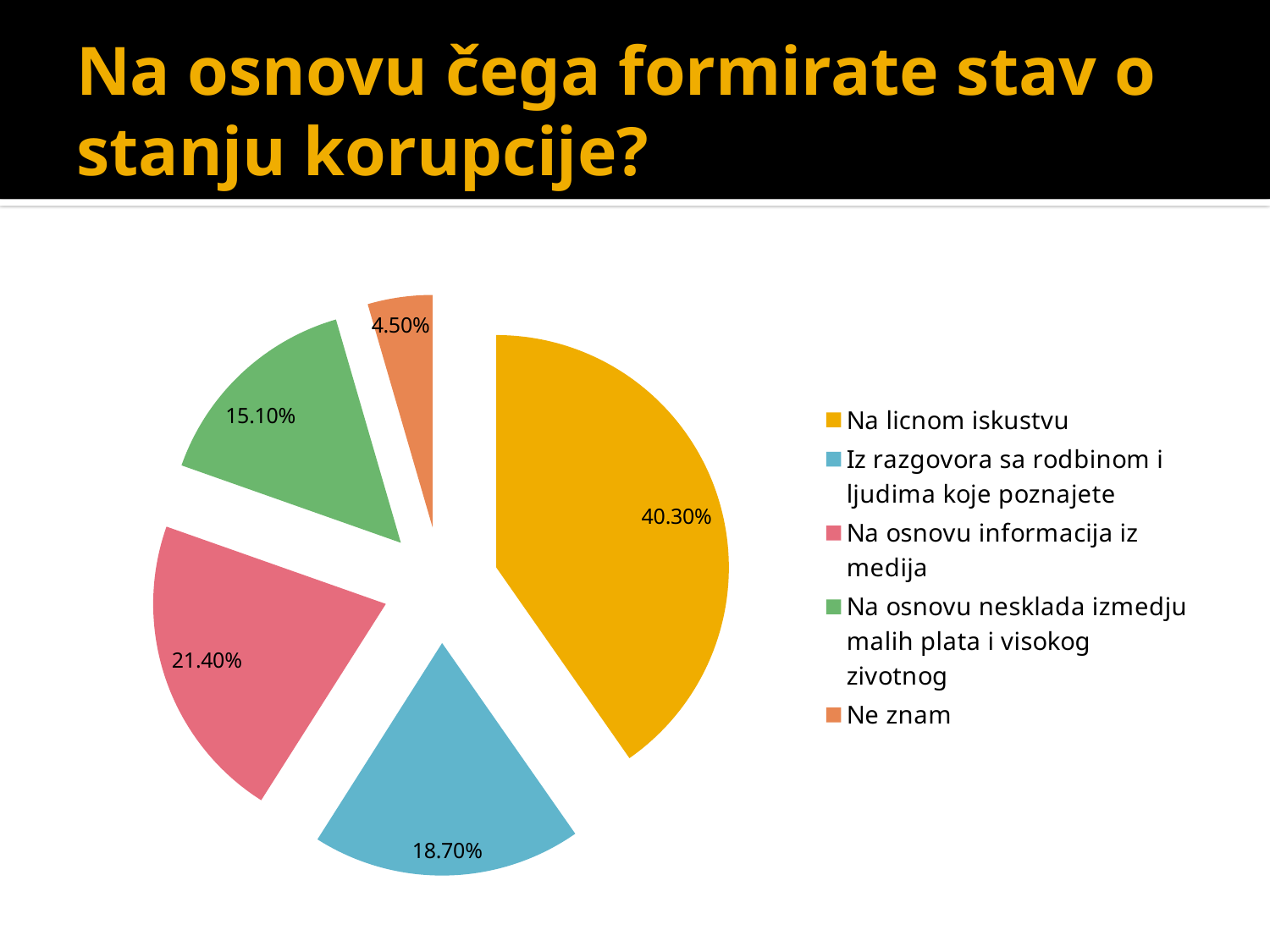
Which category has the largest share of the pie? Na licnom iskustvu Which is larger: the value for "Na osnovu informacija iz medija" or the value for "Iz razgovora sa rodbinom i ljudima koje poznajete"? Na osnovu informacija iz medija Which category has the smallest share of the pie? Ne znam What is the difference between the values for "Na licnom iskustvu" and "Na osnovu informacija iz medija"? 18.90% What is the title of the slide containing the chart? Na osnovu čega formirate stav o stanju korupcije? What is the value for "Ne znam"? 4.50% How many slices does the pie chart have? 5 What is the value for "Na licnom iskustvu"? 40.30% What kind of chart is shown on the slide? pie chart What is the value for "Na osnovu informacija iz medija"? 21.40% What is the value for "Iz razgovora sa rodbinom i ljudima koje poznajete"? 18.70%